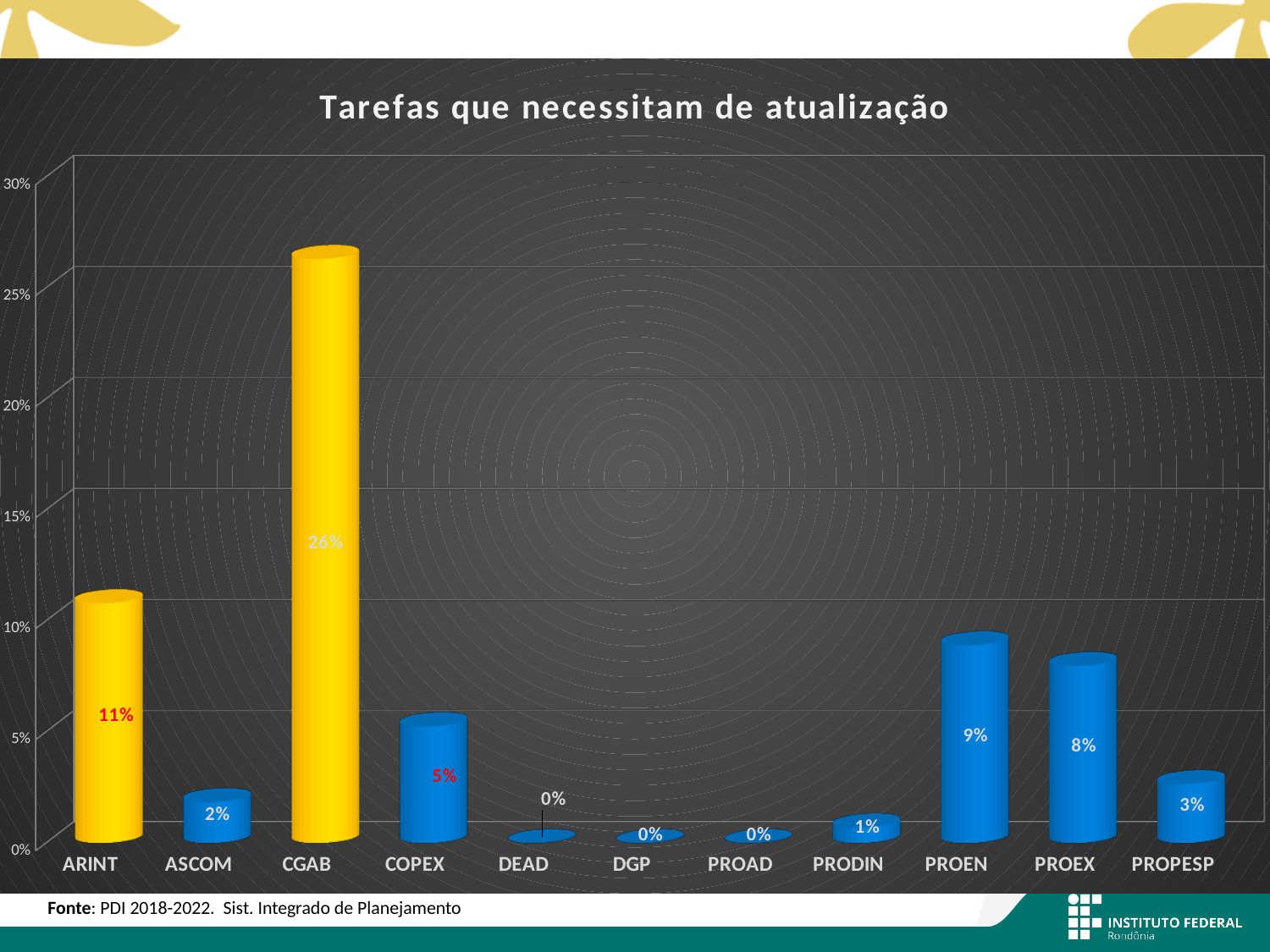
How many categories are shown on the x axis? 11 What is the value for CGAB? 26% What is the difference between the values for PROEN and PROEX? 1% What kind of chart is shown on the slide? Bar chart What is the value for PROPESP? 3% Which is larger, the value for COPEX or the value for ASCOM? COPEX What is the difference between the values for CGAB and ARINT? 15% What is the title of the chart? Tarefas que necessitam de atualização What is the value for PROEN? 9% Which category has the highest value? CGAB What is the value for ARINT? 11% Is the value for CGAB greater or less than 25%? greater